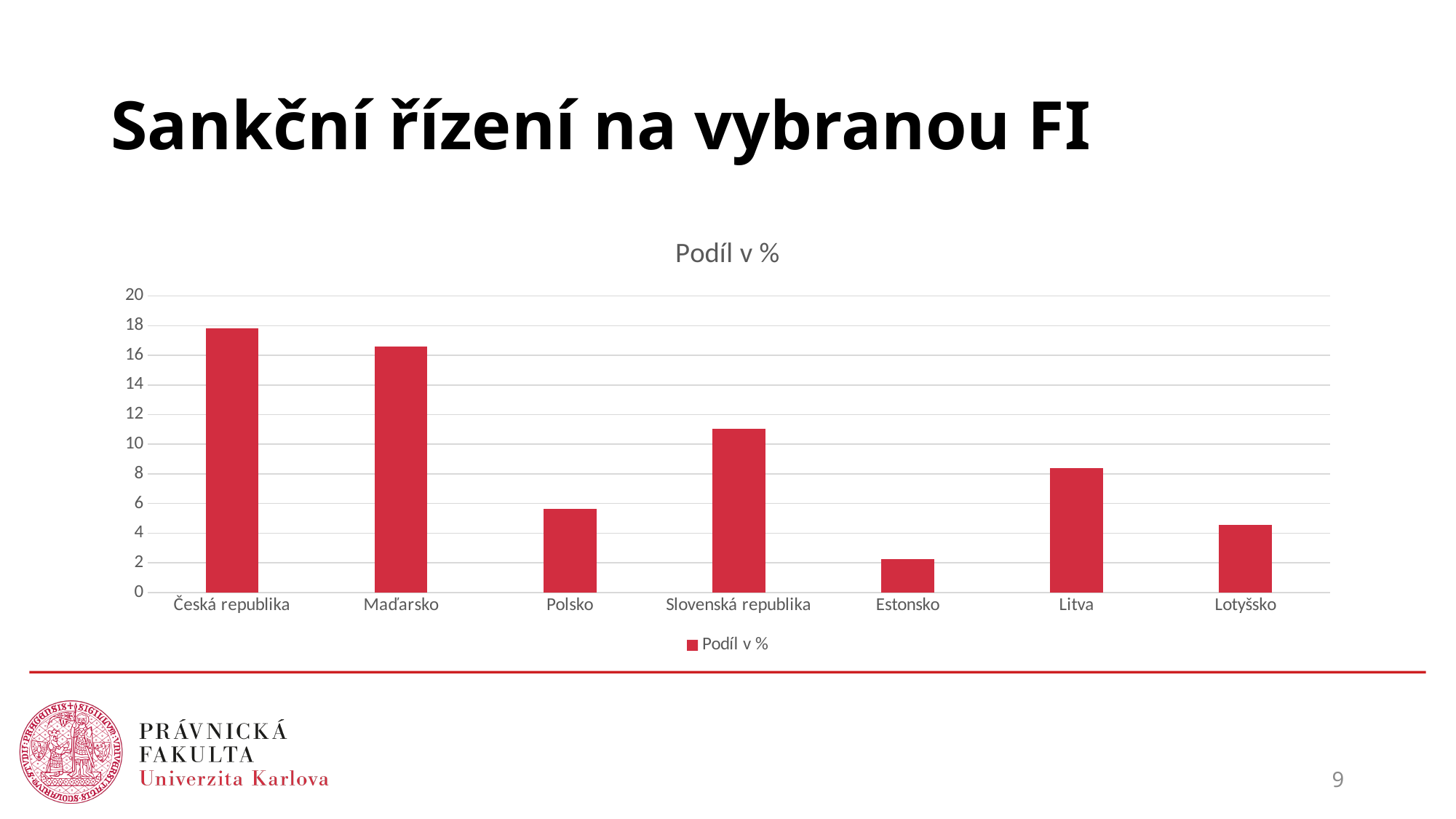
How many series does the chart legend list? 1 Is the value for Česká republika greater or less than 16? greater What kind of chart is shown on the slide? Bar chart Is the value for Estonsko greater or less than 4? less Which has a larger value, Slovenská republika or Litva? Slovenská republika Is the value for Litva greater or less than 10? less Which has a larger value, Polsko or Lotyšsko? Polsko How many countries are shown on the x axis of the chart? 7 What is the title of the chart? Podíl v % Which country has the lowest value in the chart? Estonsko Which country has the highest value in the chart? Česká republika